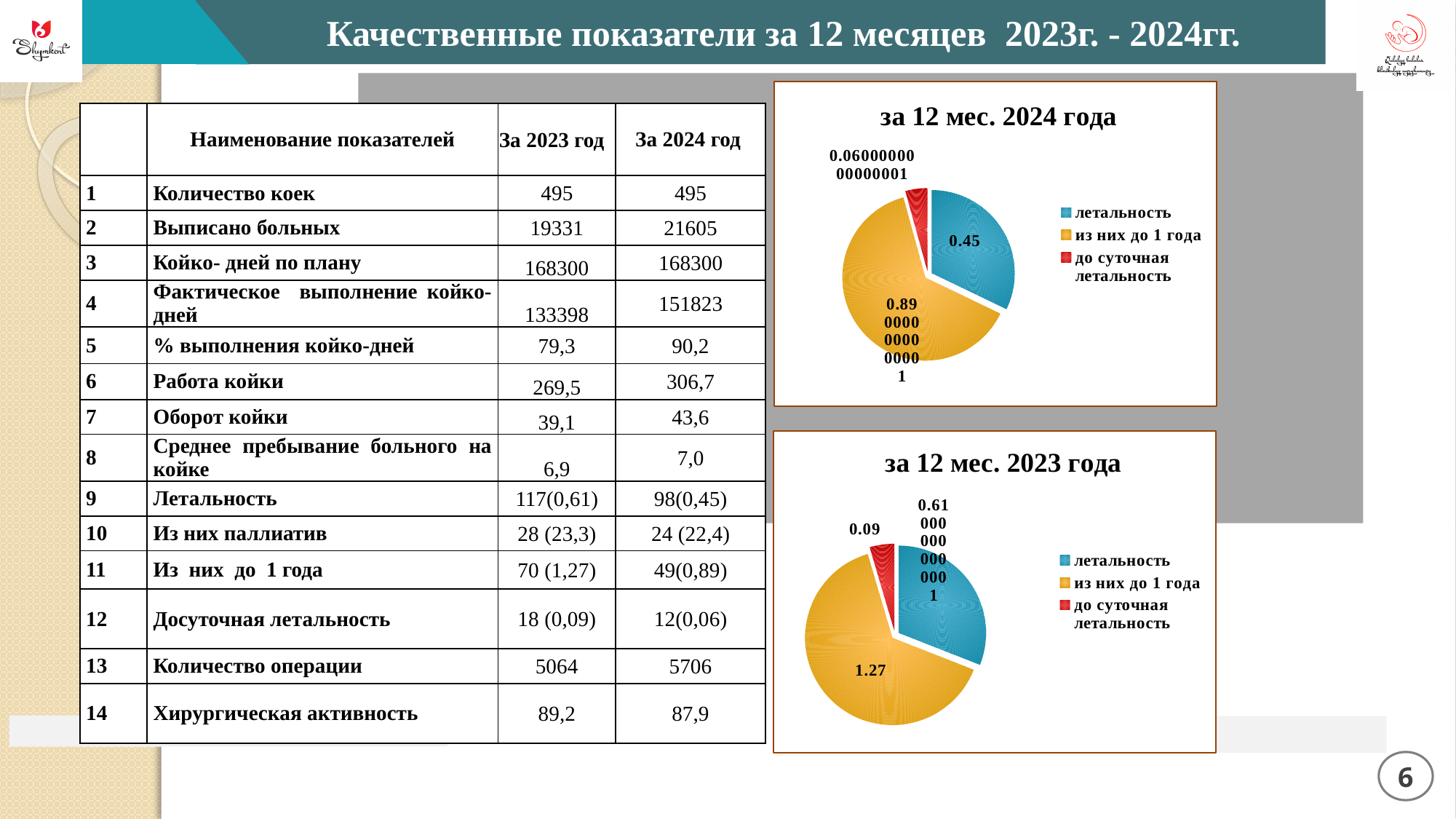
In the chart titled "за 12 мес. 2023 года", what is the value for из них до 1 года? 1.27 In the chart titled "за 12 мес. 2023 года", which category has the largest slice? из них до 1 года How many slices does the chart titled "за 12 мес. 2023 года" have? 3 In the chart titled "за 12 мес. 2023 года", what is the value for до суточная летальность? 0.09 In the chart titled "за 12 мес. 2024 года", which category has the largest slice? из них до 1 года In the chart titled "за 12 мес. 2024 года", which category has the smallest slice? до суточная летальность In the chart titled "за 12 мес. 2023 года", which is larger: летальность or до суточная летальность? летальность In the chart titled "за 12 мес. 2023 года", which category has the smallest slice? до суточная летальность In the chart titled "за 12 мес. 2023 года", what is the difference between из них до 1 года and до суточная летальность? 1.18 What kind of chart is the chart titled "за 12 мес. 2024 года"? pie chart How many entries does the legend of the chart titled "за 12 мес. 2024 года" list? 3 In the chart titled "за 12 мес. 2024 года", what is the value for летальность? 0.45